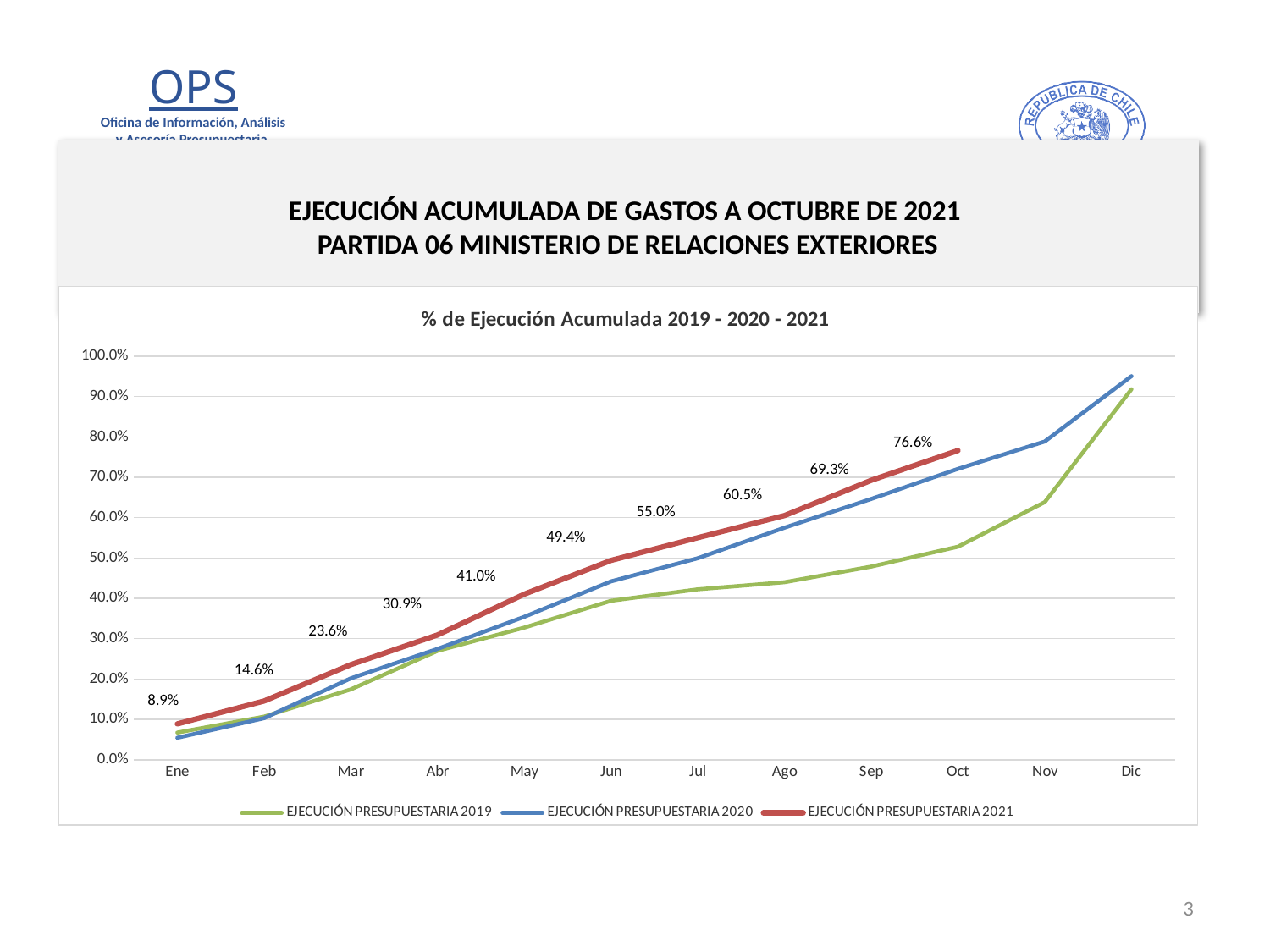
How many months are shown on the x axis? 12 What type of chart is shown on the slide? line chart What is the value for EJECUCIÓN PRESUPUESTARIA 2021 in Jun? 49.4% What is the value for EJECUCIÓN PRESUPUESTARIA 2021 in Oct? 76.6% In Dic, which series is higher: EJECUCIÓN PRESUPUESTARIA 2019 or EJECUCIÓN PRESUPUESTARIA 2020? EJECUCIÓN PRESUPUESTARIA 2020 Does the EJECUCIÓN PRESUPUESTARIA 2021 series rise or fall from Ene to Oct? rise What is the value for EJECUCIÓN PRESUPUESTARIA 2021 in Ene? 8.9% Is the value for EJECUCIÓN PRESUPUESTARIA 2019 in Oct greater or less than 60.0%? less What is the difference between the EJECUCIÓN PRESUPUESTARIA 2021 values for Sep and Ago? 8.8% What is the difference between the EJECUCIÓN PRESUPUESTARIA 2021 values for May and Abr? 10.1% What is the chart's title? % de Ejecución Acumulada 2019 - 2020 - 2021 How many series does the legend list? 3